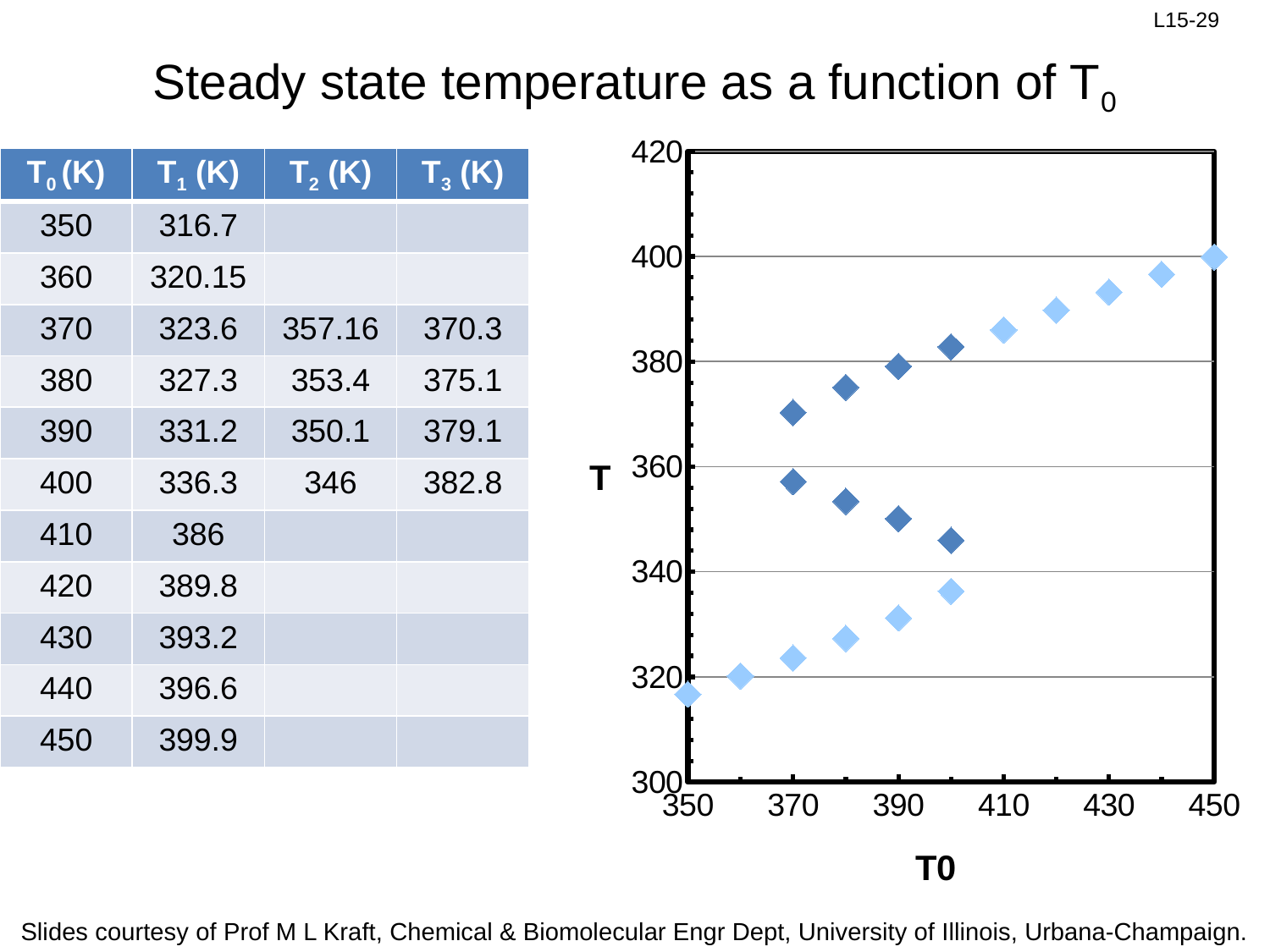
According to the table, what is the value of T3 when T0 is 390 K? 379.1 What is the label on the x axis of the chart? T0 What is the difference between T3 and T2 at T0 = 400 K? 36.8 What is the label on the y axis of the chart? T Is the lowest plotted T value at T0 = 400 greater or less than 340? less At T0 = 370, which is larger, T2 or T3? T3 Is the plotted T value at T0 = 450 greater or less than 380? greater At which T0 value does the chart reach its highest plotted temperature T? 450 At which T0 value does the chart show its lowest plotted temperature T? 350 According to the table, what is the value of T1 when T0 is 400 K? 336.3 How many data points are plotted at T0 = 400 on the chart? 3 What kind of chart is shown on the slide? Scatter chart